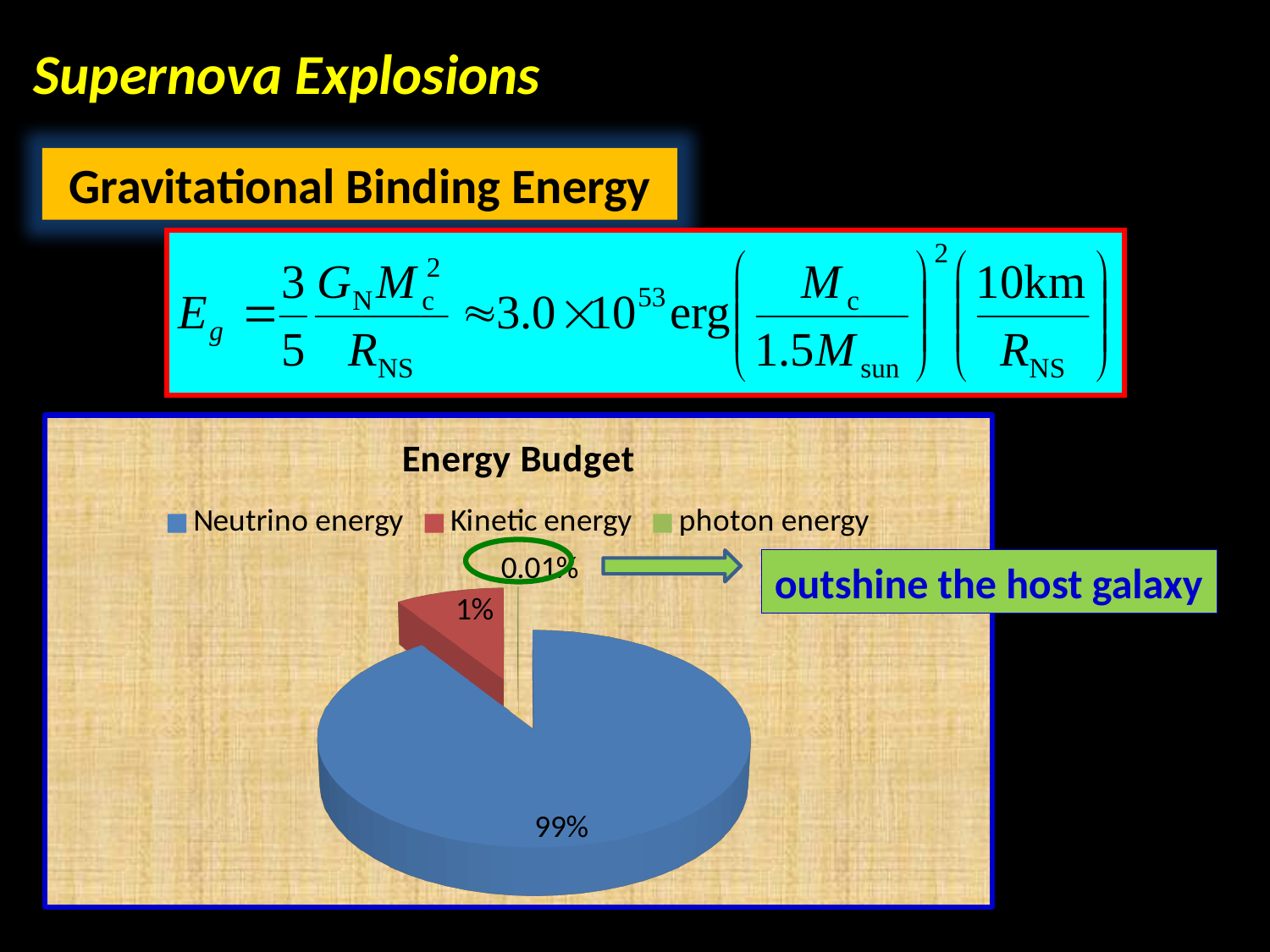
Which colour represents Kinetic energy in the Energy Budget chart? red What share of the Energy Budget pie is photon energy? 0.01% What kind of chart is shown on the slide? pie chart In the Energy Budget chart, what is the difference between the Neutrino energy share and the Kinetic energy share? 98% How many entries does the legend of the Energy Budget chart list? 3 What share of the Energy Budget pie is Neutrino energy? 99% What is the title of the chart on the slide? Energy Budget In the Energy Budget chart, which is larger, Kinetic energy or photon energy? Kinetic energy What share of the Energy Budget pie is Kinetic energy? 1% How many slices does the Energy Budget pie chart have? 3 Which category has the smallest slice in the Energy Budget pie chart? photon energy Which category has the largest slice in the Energy Budget pie chart? Neutrino energy